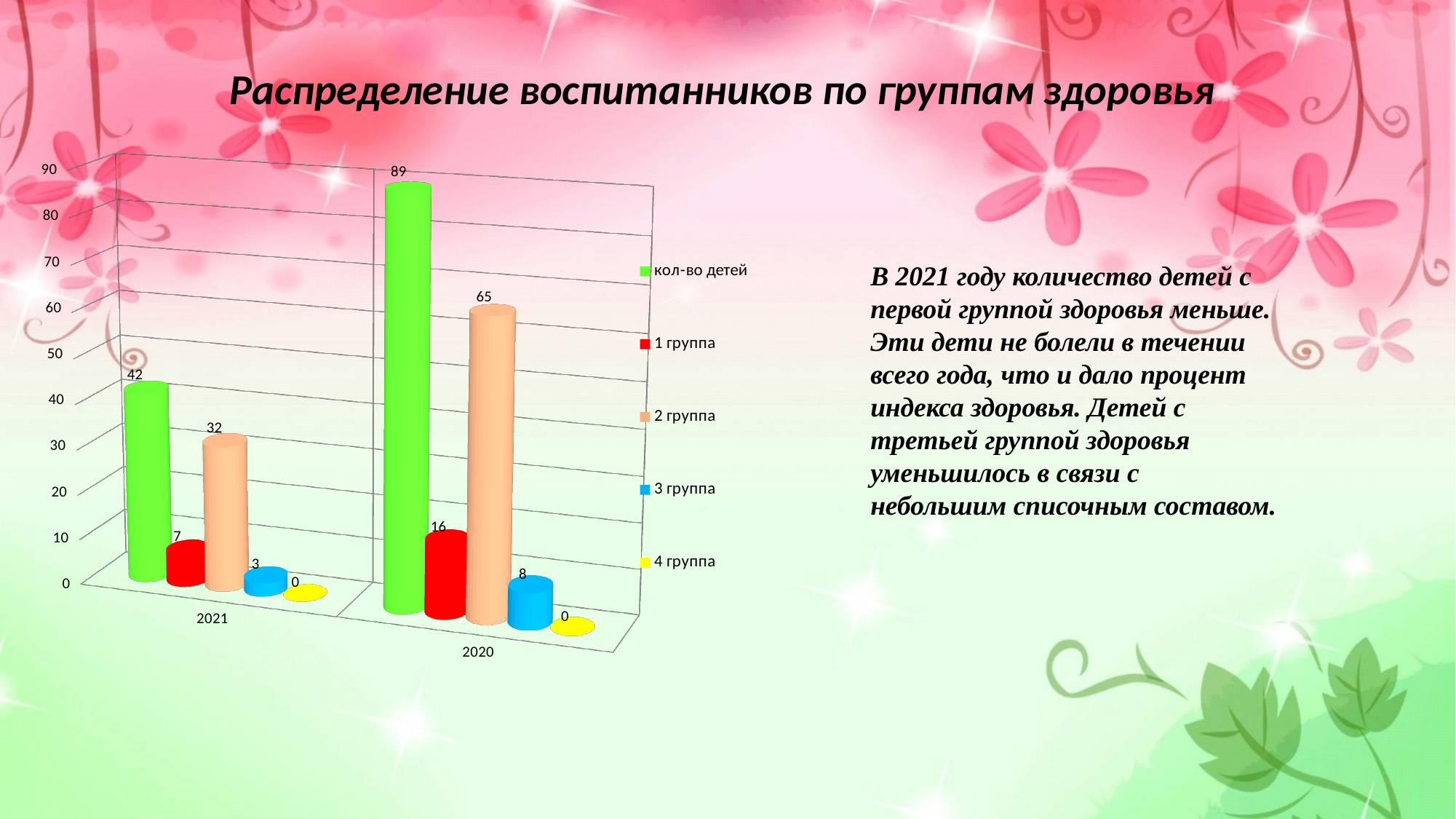
How many series does the legend list? 5 How many categories are shown on the x axis? 2 What is the value for "3 группа" in 2020? 8 What is the value for "1 группа" in 2021? 7 What kind of chart is shown on the slide? Bar chart Which series has the highest value in 2020? кол-во детей Which series has the lowest value in 2021? 4 группа What is the value for "2 группа" in 2020? 65 Which is larger: "2 группа" in 2021 or "1 группа" in 2020? 2 группа in 2021 What is the value for "4 группа" in 2021? 0 What is the value for "кол-во детей" in 2021? 42 What is the difference between "кол-во детей" in 2020 and in 2021? 47